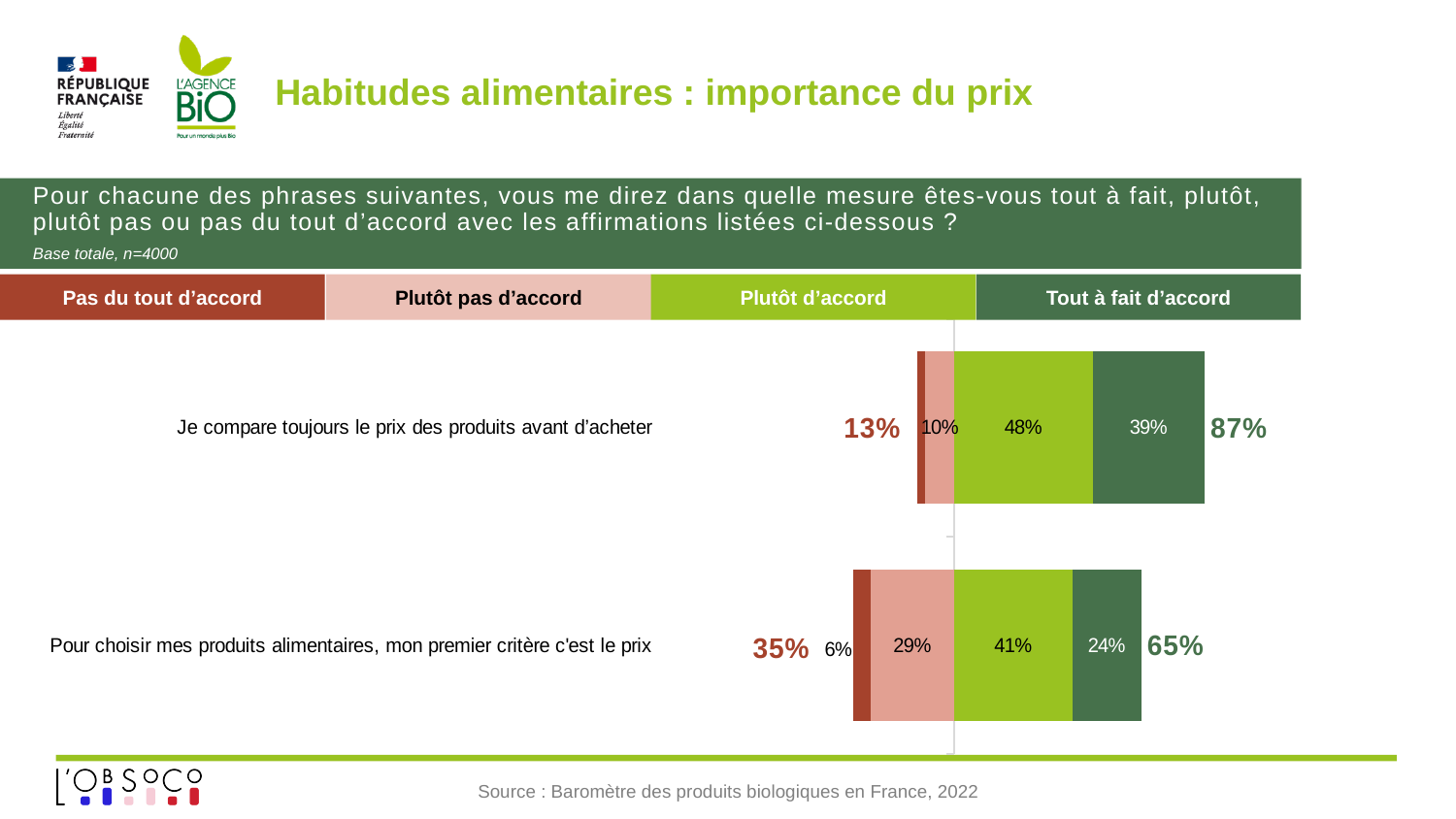
How many response categories does the legend list? 4 What is the total agreement (Plutôt d'accord + Tout à fait d'accord) shown for 'Je compare toujours le prix des produits avant d'acheter'? 87% How many statements are plotted in the chart? 2 What is the 'Plutôt pas d'accord' value for 'Pour choisir mes produits alimentaires, mon premier critère c'est le prix'? 29% What is the 'Plutôt d'accord' value for 'Je compare toujours le prix des produits avant d'acheter'? 48% What is the difference between the 'Plutôt d'accord' values of the two statements? 7% Which statement has the higher 'Tout à fait d'accord' value? Je compare toujours le prix des produits avant d'acheter What is the 'Tout à fait d'accord' value for 'Pour choisir mes produits alimentaires, mon premier critère c'est le prix'? 24% Which colour represents 'Tout à fait d'accord' in the legend? dark green What is the 'Pas du tout d'accord' value for 'Pour choisir mes produits alimentaires, mon premier critère c'est le prix'? 6% What type of chart is shown on the slide? stacked bar chart What is the total disagreement shown for 'Pour choisir mes produits alimentaires, mon premier critère c'est le prix'? 35%